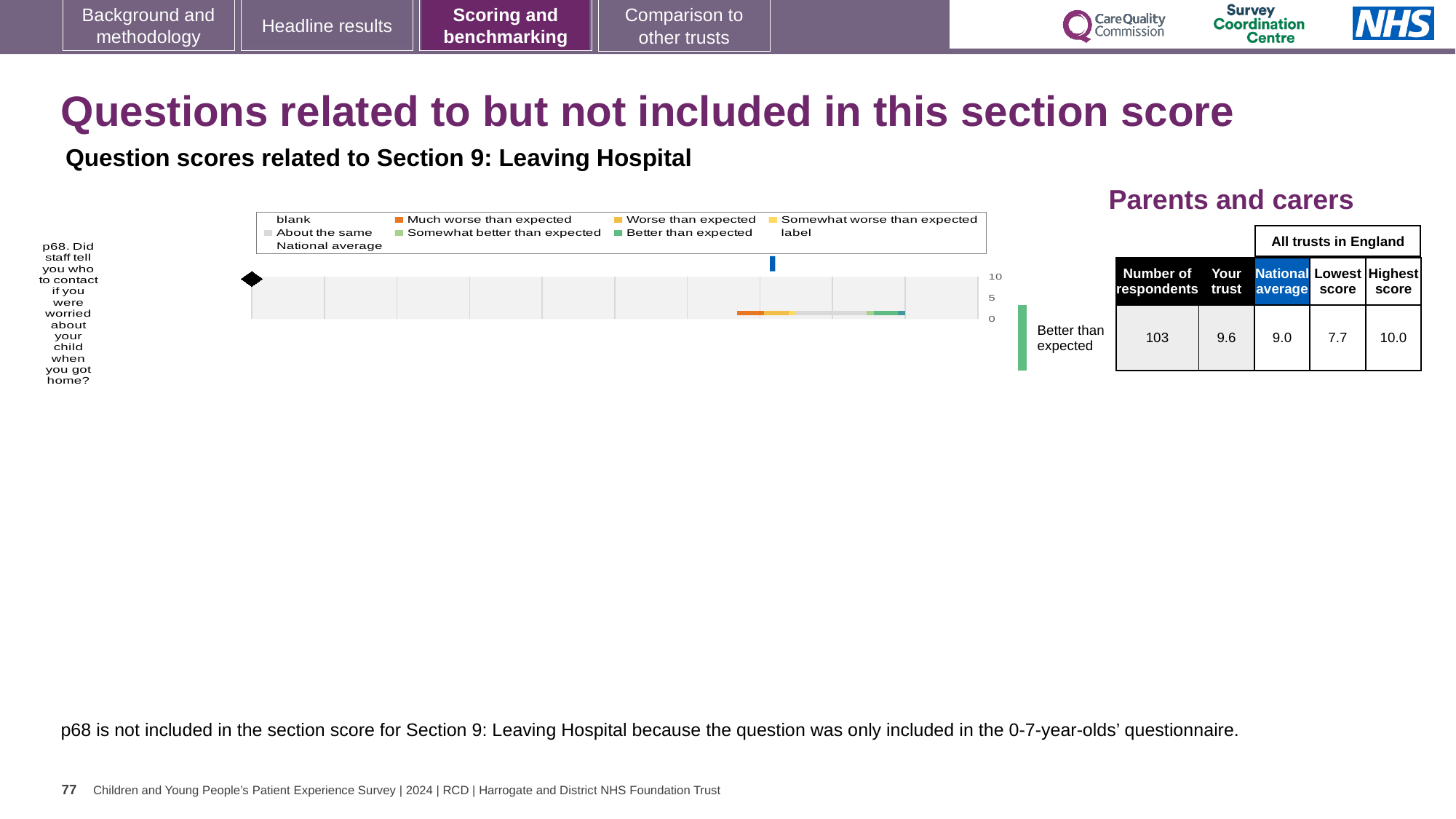
How many respondents answered p68 according to the table beside the chart? 103 In the table beside the chart, what is the Highest score among all trusts in England for p68? 10.0 In the table beside the chart, what is the National average score for p68? 9.0 How many questions (categories) are plotted on the chart? 1 What is the highest value shown on the chart's axis? 10 In the table beside the chart, what is the 'Your trust' score for p68? 9.6 In the table beside the chart, what is the Lowest score among all trusts in England for p68? 7.7 Which question number is plotted on the chart? p68 Which is larger for p68, the 'Your trust' score or the National average? Your trust What is the difference between the 'Your trust' score and the National average for p68? 0.6 What kind of chart is shown for question p68? bar chart How many entries does the chart legend list? 9